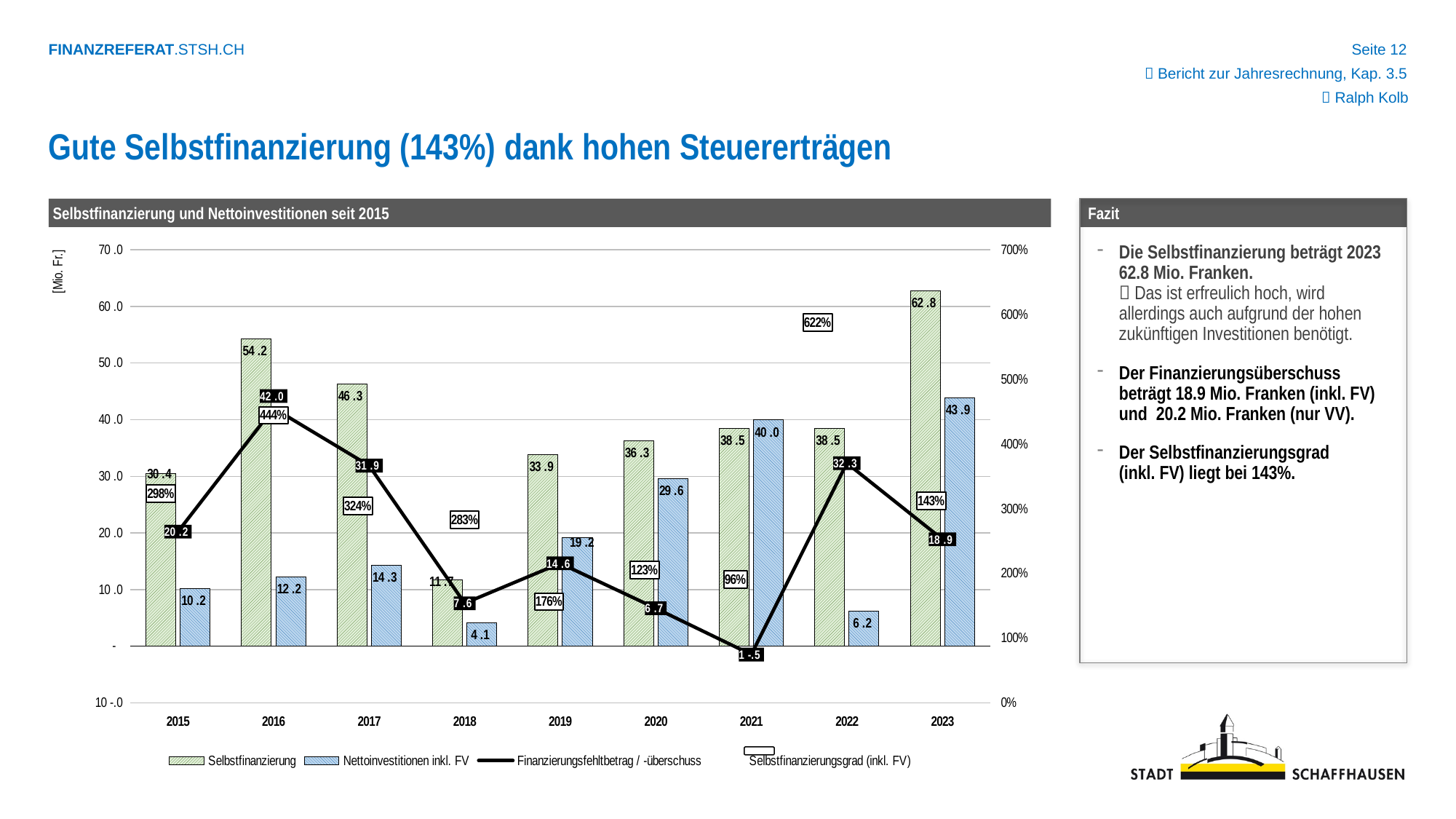
What is the value of Nettoinvestitionen inkl. FV for 2021? 40.0 What is the Selbstfinanzierungsgrad (inkl. FV) for 2016? 444% What is the value of the Finanzierungsfehlbetrag / -überschuss line for 2021? -1.5 What is the title of the chart? Selbstfinanzierung und Nettoinvestitionen seit 2015 In 2020, which is larger: Selbstfinanzierung or Nettoinvestitionen inkl. FV? Selbstfinanzierung In which year is the Selbstfinanzierung bar the lowest? 2018 What is the difference between Selbstfinanzierung and Nettoinvestitionen inkl. FV in 2023? 18.9 How many years are shown on the x axis of the chart? 9 What is the Selbstfinanzierung value for 2023? 62.8 How many series does the chart legend list? 4 What kind of chart is shown on the slide? Combined bar and line chart In which year is the Selbstfinanzierungsgrad (inkl. FV) the highest? 2022